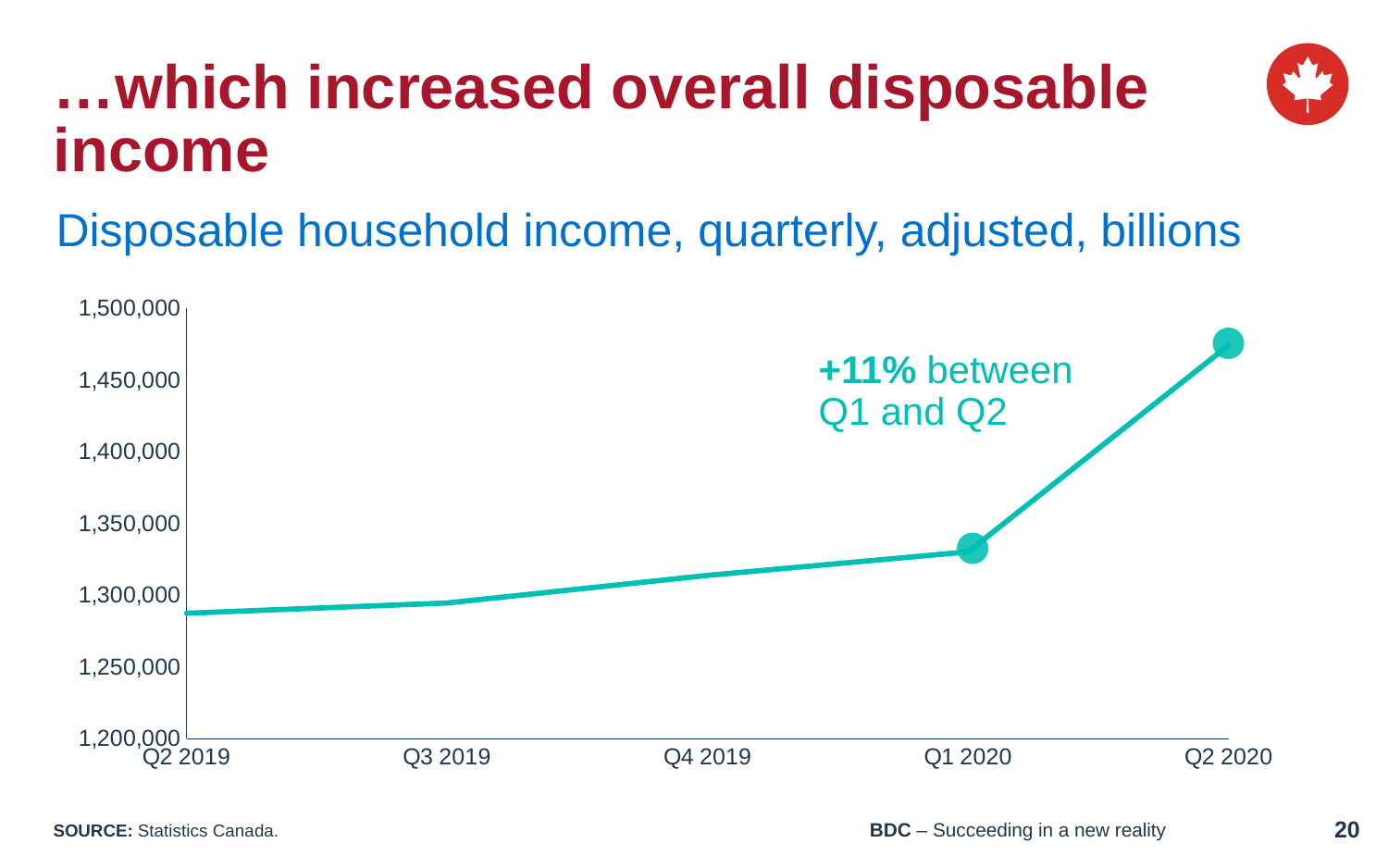
Is the value for Q1 2020 greater or less than 1,350,000? less Do the values rise or fall from Q2 2019 to Q2 2020? rise Is the value for Q2 2020 greater or less than 1,500,000? less Which is larger, the value for Q1 2020 or the value for Q2 2020? Q2 2020 What kind of chart is shown on the slide? line chart What is the title of the chart? Disposable household income, quarterly, adjusted, billions How many quarters are plotted on the x axis? 5 Is the value for Q2 2020 greater or less than 1,450,000? greater According to the annotation on the chart, what was the percentage change between Q1 and Q2? +11% Which quarter has the highest disposable household income? Q2 2020